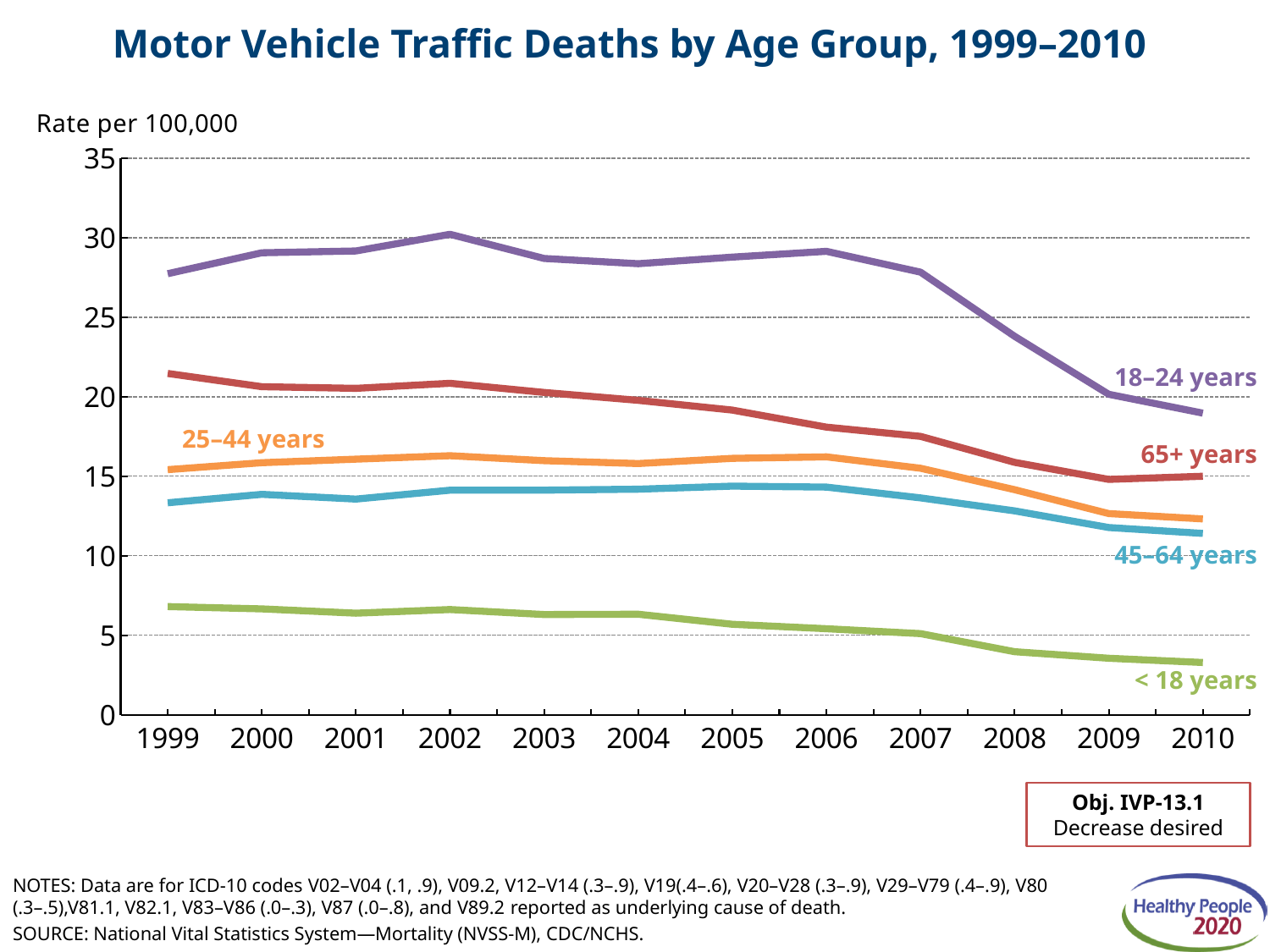
Is the rate for the 45–64 years group in 2009 greater or less than 10? greater What is the title of the chart? Motor Vehicle Traffic Deaths by Age Group, 1999–2010 Does the rate for the 18–24 years group rise or fall from 2007 to 2010? fall Is the rate for the 65+ years group in 1999 greater or less than 20? greater How many years are shown along the x axis? 12 Is the rate for the 18–24 years group in 2008 greater or less than 25? less What kind of chart is shown on the slide? line chart Which age group has the highest motor vehicle traffic death rate throughout 1999–2010? 18–24 years Which age group has the lowest motor vehicle traffic death rate throughout 1999–2010? < 18 years In 2010, which group has the higher rate: 65+ years or 25–44 years? 65+ years How many age groups are plotted on the chart? 5